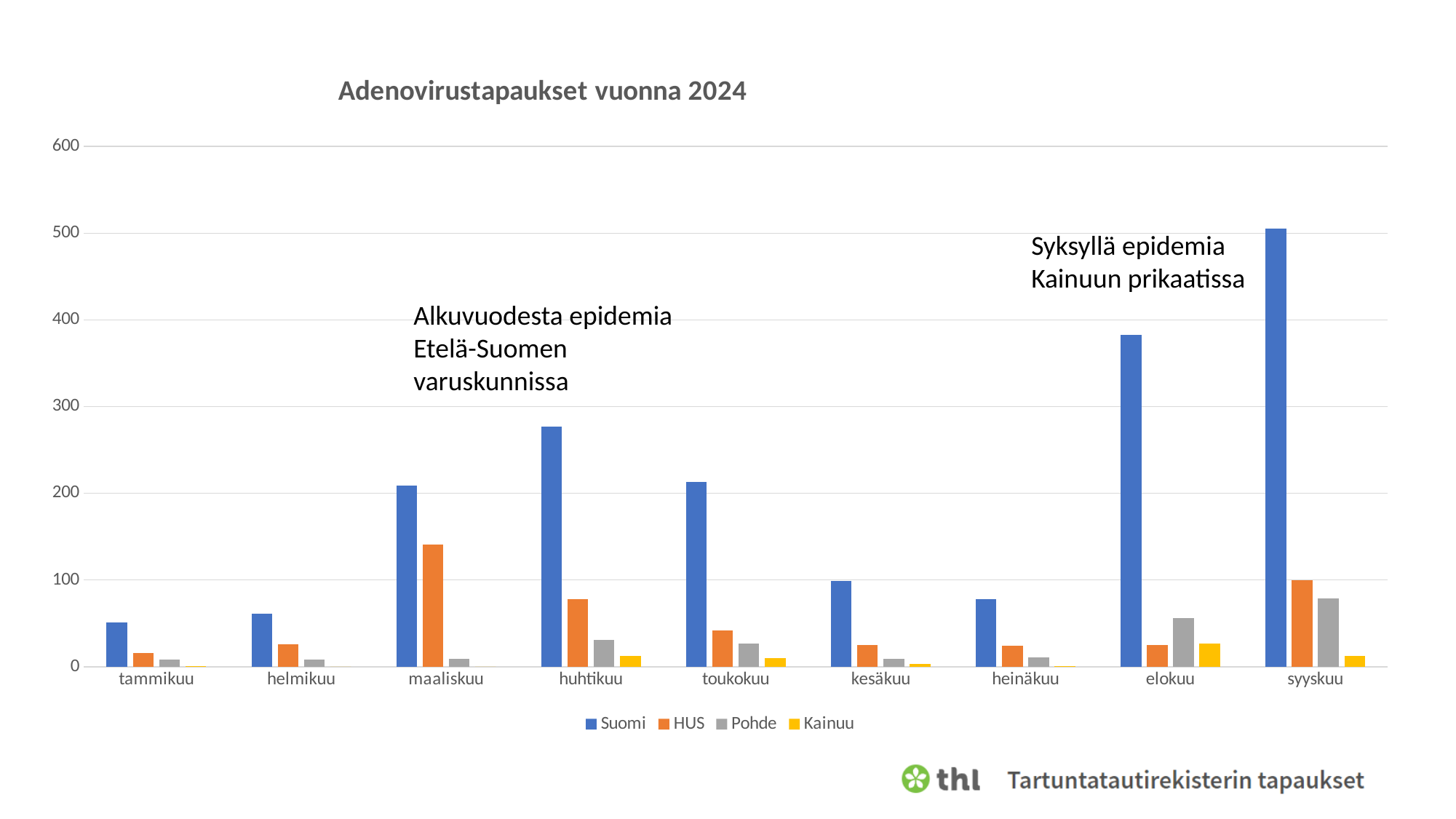
What kind of chart is shown on the slide? bar chart How many months are shown on the x axis? 9 What is the title of the chart? Adenovirustapaukset vuonna 2024 Is the Suomi value for elokuu greater or less than 400? less Do the Suomi values rise or fall from heinäkuu to syyskuu? rise In which month is the Kainuu value highest? elokuu Which is larger, the Suomi value for huhtikuu or for toukokuu? huhtikuu In which month is the Pohde value highest? syyskuu How many series does the legend list? 4 In which month is the HUS value highest? maaliskuu Is the Suomi value for syyskuu greater or less than 400? greater